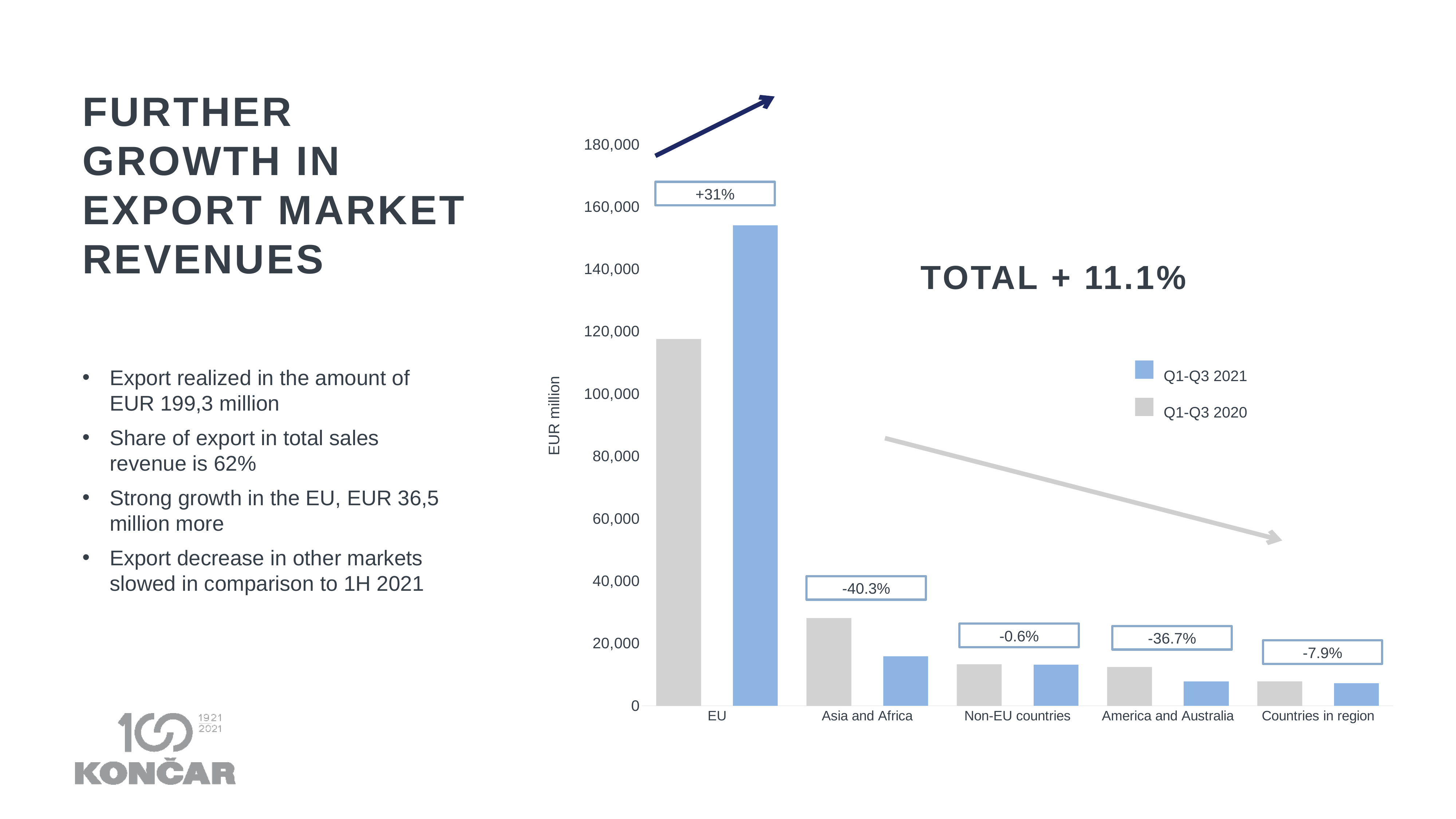
Is the Q1-Q3 2021 value for EU greater or less than 140,000? greater How many categories are shown on the x axis? 5 What percentage change is labelled above the EU bars? +31% Which category has the lowest Q1-Q3 2020 value? Countries in region What percentage change is labelled above the Countries in region bars? -7.9% What percentage change is labelled above the America and Australia bars? -36.7% What kind of chart is shown on the slide? bar chart What percentage change is labelled above the Asia and Africa bars? -40.3% Which category has the highest Q1-Q3 2021 value? EU For Asia and Africa, which is larger: the Q1-Q3 2020 value or the Q1-Q3 2021 value? Q1-Q3 2020 Is the Q1-Q3 2021 value for Asia and Africa greater or less than 20,000? less How many series does the legend list? 2